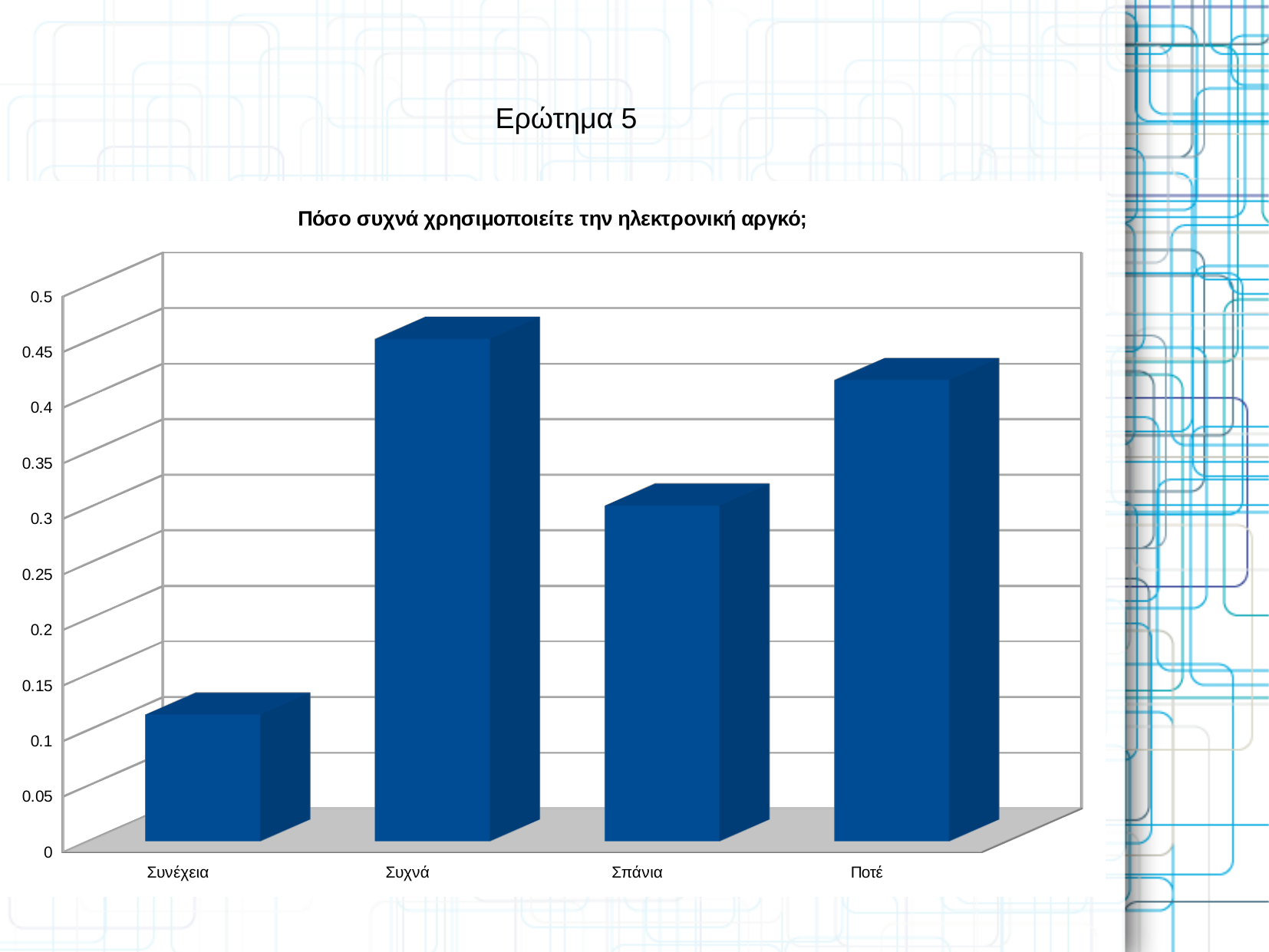
What is the title of the chart? Πόσο συχνά χρησιμοποιείτε την ηλεκτρονική αργκό; What is the highest value shown on the vertical axis of the chart? 0.5 Is the value for Σπάνια greater or less than 0.25? greater Which is larger, the value for Συχνά or the value for Ποτέ? Συχνά Which category has the lowest value? Συνέχεια Is the value for Συχνά greater or less than 0.4? greater What kind of chart is shown on the slide? Bar chart Which is larger, the value for Ποτέ or the value for Σπάνια? Ποτέ Is the value for Συνέχεια greater or less than 0.2? less How many categories are shown on the x axis of the chart? 4 Which category has the highest value? Συχνά